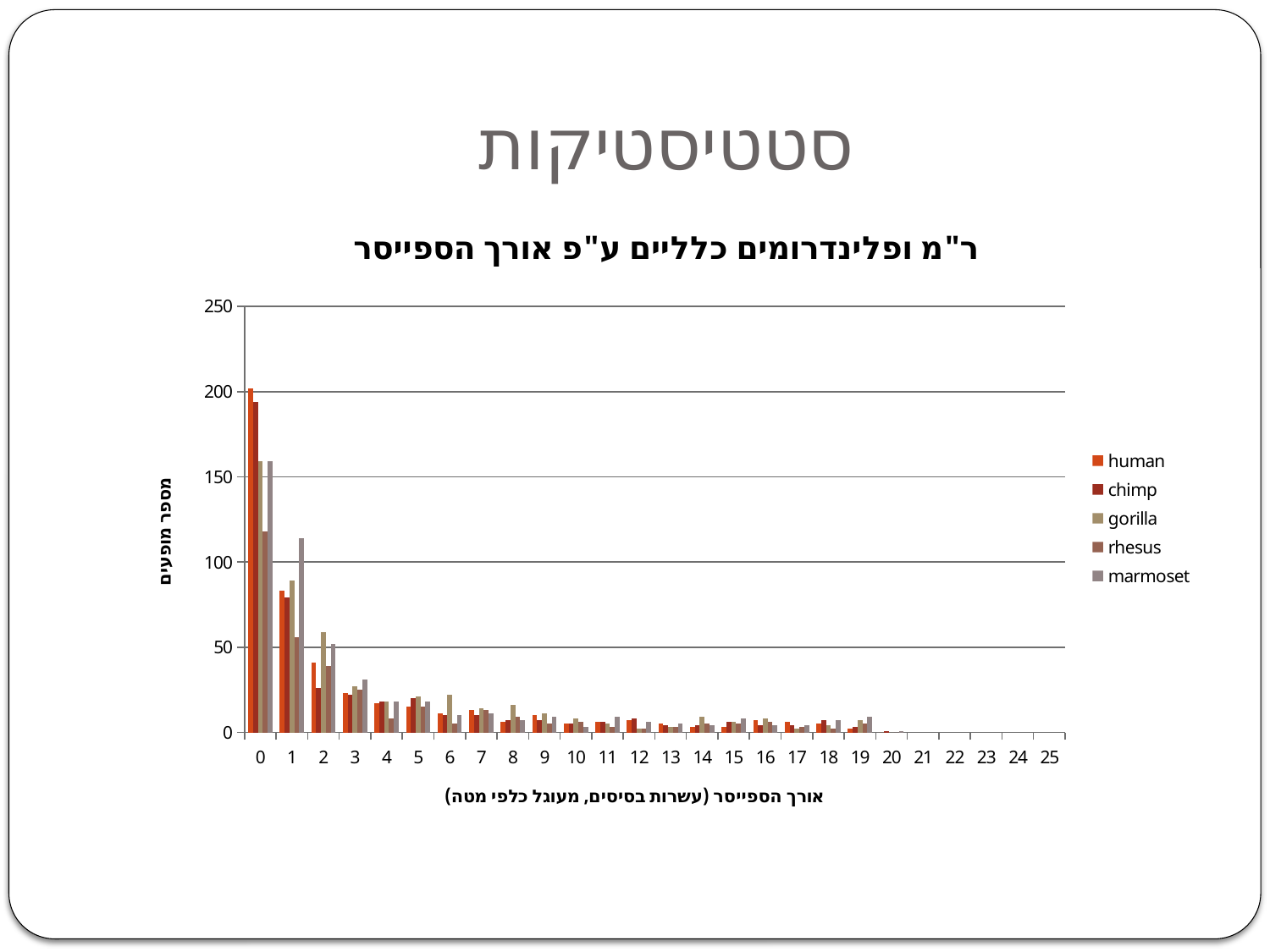
Do the values generally rise or fall as the spacer length increases along the x axis? fall Is the value for human at spacer length 2 greater or less than 50? less At which spacer length do all series reach their highest values? 0 How many spacer-length categories are shown along the x axis? 26 Is the value for marmoset at spacer length 1 greater or less than 100? greater Which series has the highest value at spacer length 0? human Is the value for human at spacer length 0 greater or less than 150? greater What kind of chart is shown on the slide? bar chart How many series does the legend list? 5 At spacer length 1, which is larger: the value for marmoset or the value for chimp? marmoset At spacer length 2, which is larger: the value for gorilla or the value for chimp? gorilla